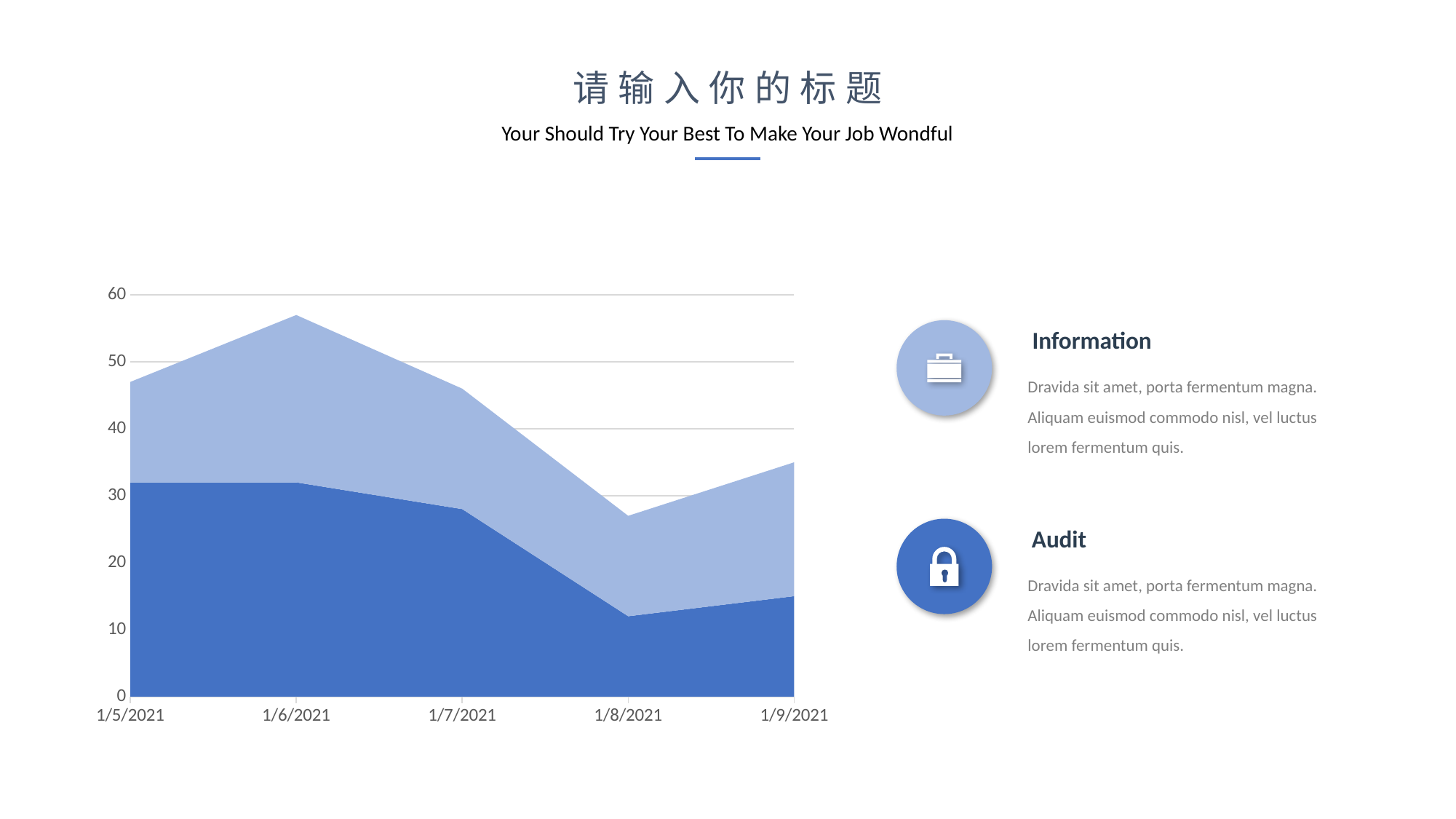
Is the value of the dark blue (bottom) series at 1/5/2021 greater or less than 30? greater Is the top of the stacked area higher at 1/5/2021 or at 1/9/2021? 1/5/2021 On which date does the top of the stacked area reach its highest point? 1/6/2021 On which date does the top of the stacked area reach its lowest point? 1/8/2021 What kind of chart is shown on the slide? area chart How many dates are plotted along the x axis of the chart? 5 Is the top of the stacked area at 1/8/2021 greater or less than 30? less Does the top of the stacked area rise or fall from 1/6/2021 to 1/8/2021? fall What is the highest value shown on the y axis of the chart? 60 Is the top of the stacked area at 1/6/2021 greater or less than 50? greater How many shaded series are stacked in the chart? 2